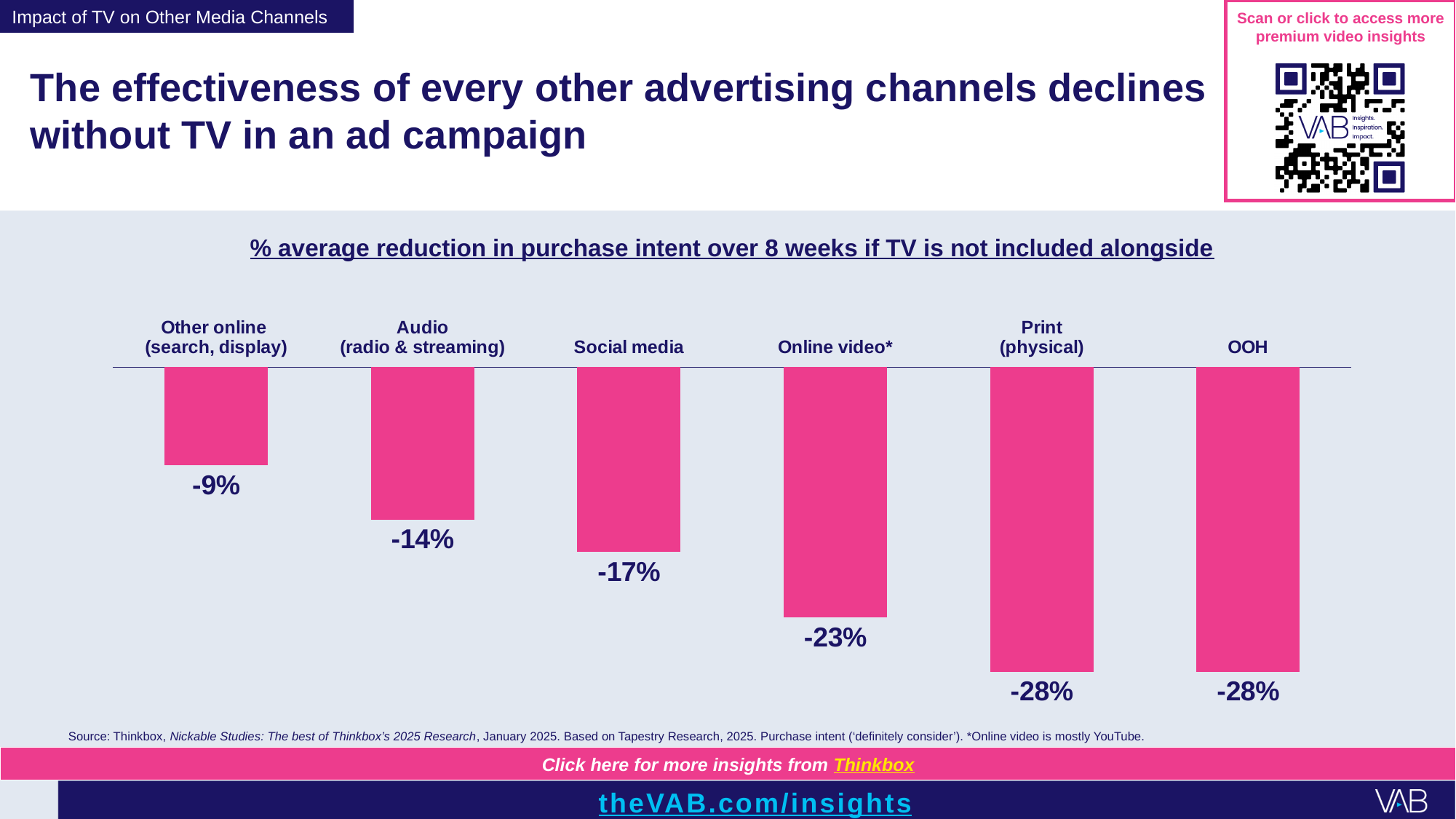
Do the reductions get larger or smaller moving from left to right across the chart? Larger Which shows a larger reduction in purchase intent, Audio (radio & streaming) or Online video*? Online video* What kind of chart is shown on the slide? Bar chart What is the title of the chart? % average reduction in purchase intent over 8 weeks if TV is not included alongside What is the value for OOH? -28% What is the value for Audio (radio & streaming)? -14% Which category has the smallest reduction in purchase intent? Other online (search, display) How many categories are shown in the chart? 6 What is the difference between the values for Print (physical) and Other online (search, display)? 19 percentage points What is the value for Online video*? -23% What is the difference between the values for Online video* and Social media? 6 percentage points What is the value for Social media? -17%